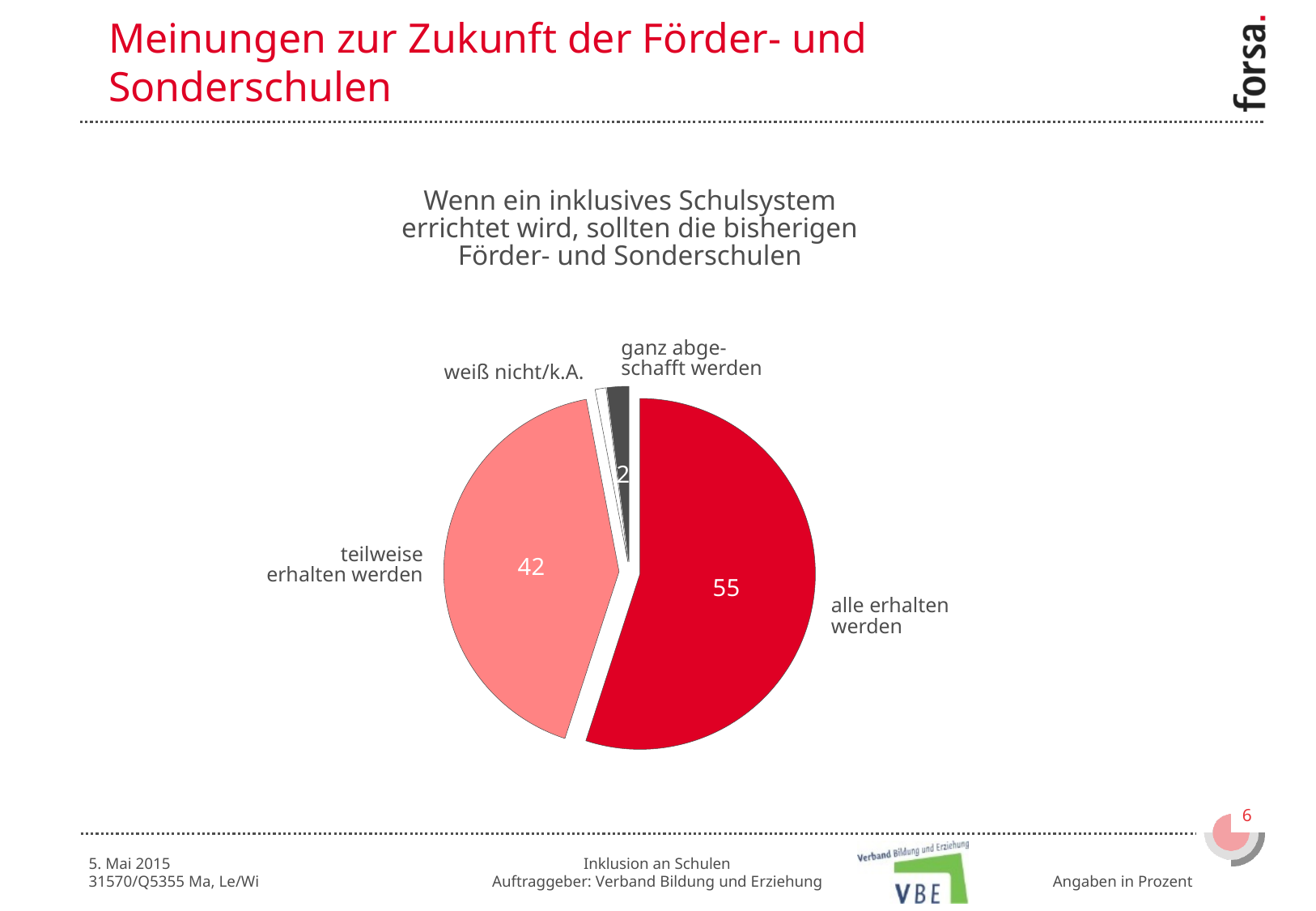
What share of the pie does "alle erhalten werden" represent, in percent? 55 How many slices does the pie chart have? 4 Which slice of the pie chart is the largest? alle erhalten werden Which slice of the pie chart is the smallest? weiß nicht/k.A. Which is larger: "teilweise erhalten werden" or "ganz abgeschafft werden"? teilweise erhalten werden What value is shown for the slice "teilweise erhalten werden"? 42 What value is shown for the slice "alle erhalten werden"? 55 In what unit are the values in the chart given, according to the note at the bottom right of the slide? Prozent What is the title of the slide? Meinungen zur Zukunft der Förder- und Sonderschulen What is the difference between the values for "alle erhalten werden" and "teilweise erhalten werden"? 13 What value is shown for the slice "ganz abgeschafft werden"? 2 What kind of chart is shown on the slide? pie chart